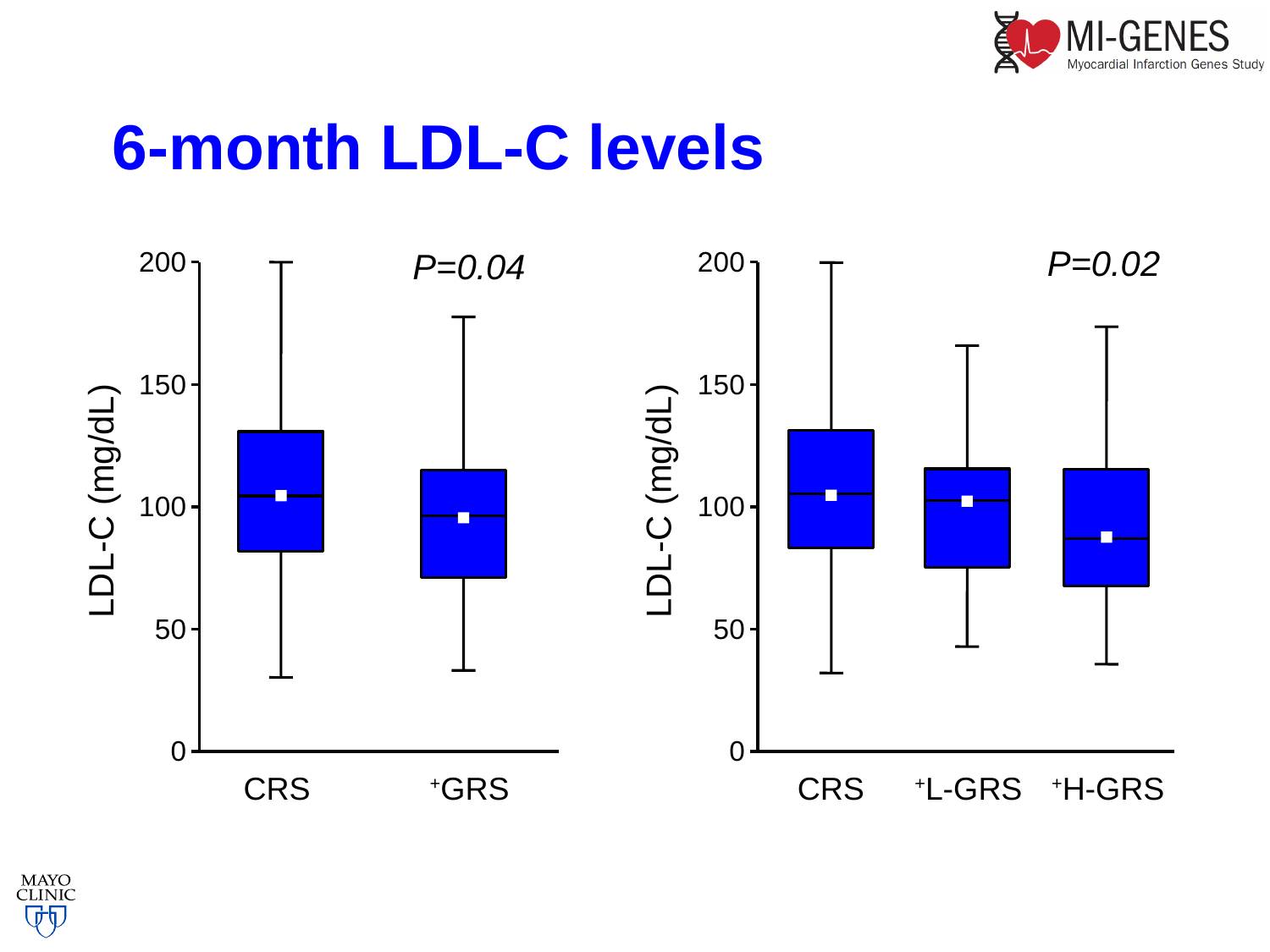
In the right chart, is the median for +H-GRS greater or less than 100? less In the right chart, how many categories are shown on the x axis? 3 In the left chart, what value does the upper whisker for CRS reach? 200 In the right chart, which has the higher median LDL-C, CRS or +H-GRS? CRS In the left chart, how many categories are shown on the x axis? 2 What kind of chart is shown on the left of the slide? box plot In the right chart, which category has the lowest median LDL-C? +H-GRS In the right chart, is the top of the box for CRS greater or less than 150? less In the left chart, is the upper whisker for +GRS greater or less than 200? less In the left chart, what is the P value printed on the chart? P=0.04 In the right chart, what is the P value printed on the chart? P=0.02